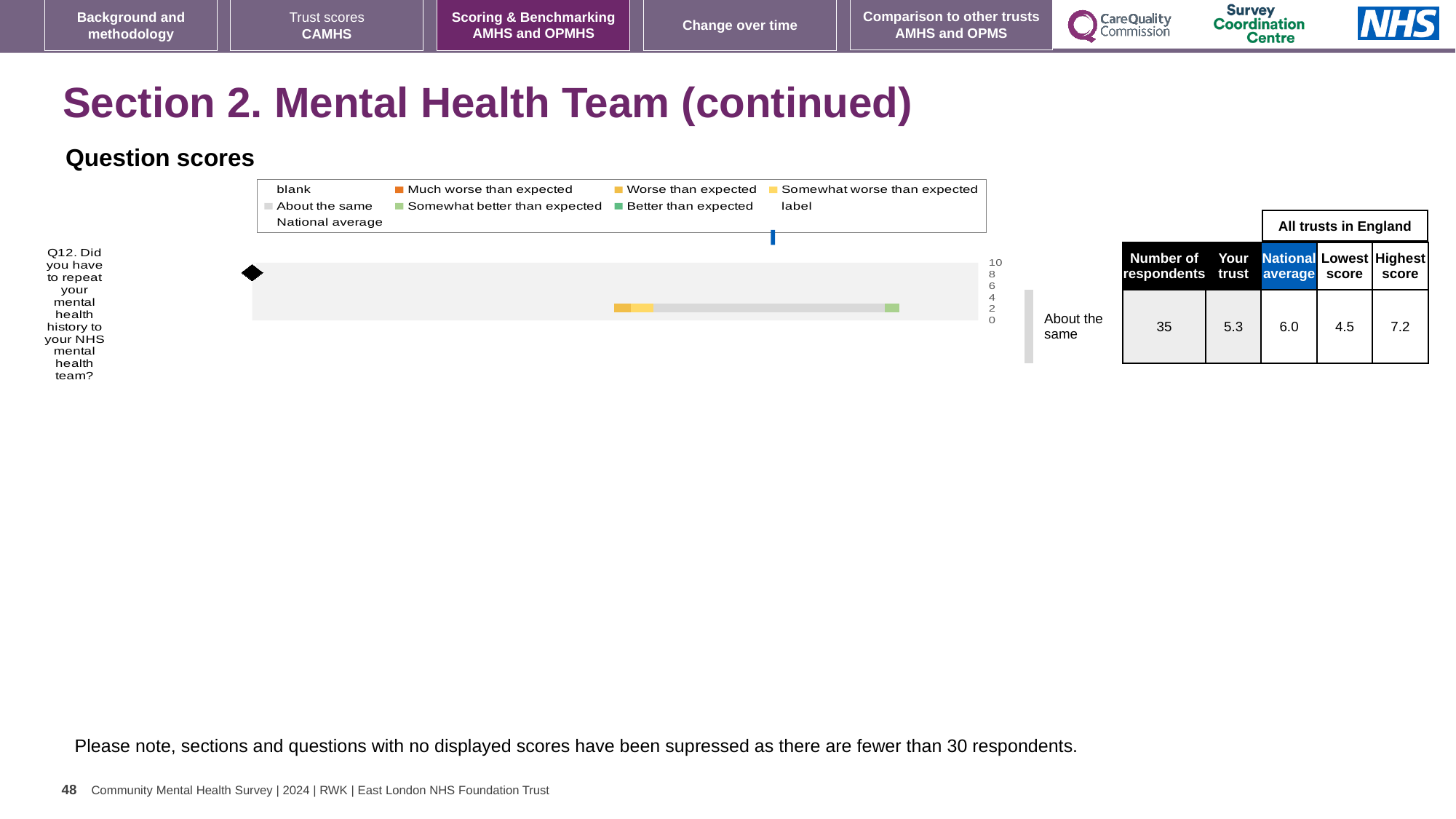
What is the lowest score among all trusts in England for Q12? 4.5 Is the 'Your trust' score for Q12 higher or lower than the national average? lower What kind of chart is used to show the Q12 question score? bar chart What is the difference between the national average and the 'Your trust' score for Q12? 0.7 What is the national average score for Q12? 6.0 What is the difference between the highest score and the lowest score for Q12? 2.7 Which benchmark category is Q12 placed in, according to the label next to the chart? About the same What is the 'Your trust' score for Q12 in the table beside the chart? 5.3 What is the highest score among all trusts in England for Q12? 7.2 How many respondents answered Q12? 35 How many questions are plotted in the Question scores chart? 1 What colour represents 'Much worse than expected' in the chart legend? orange